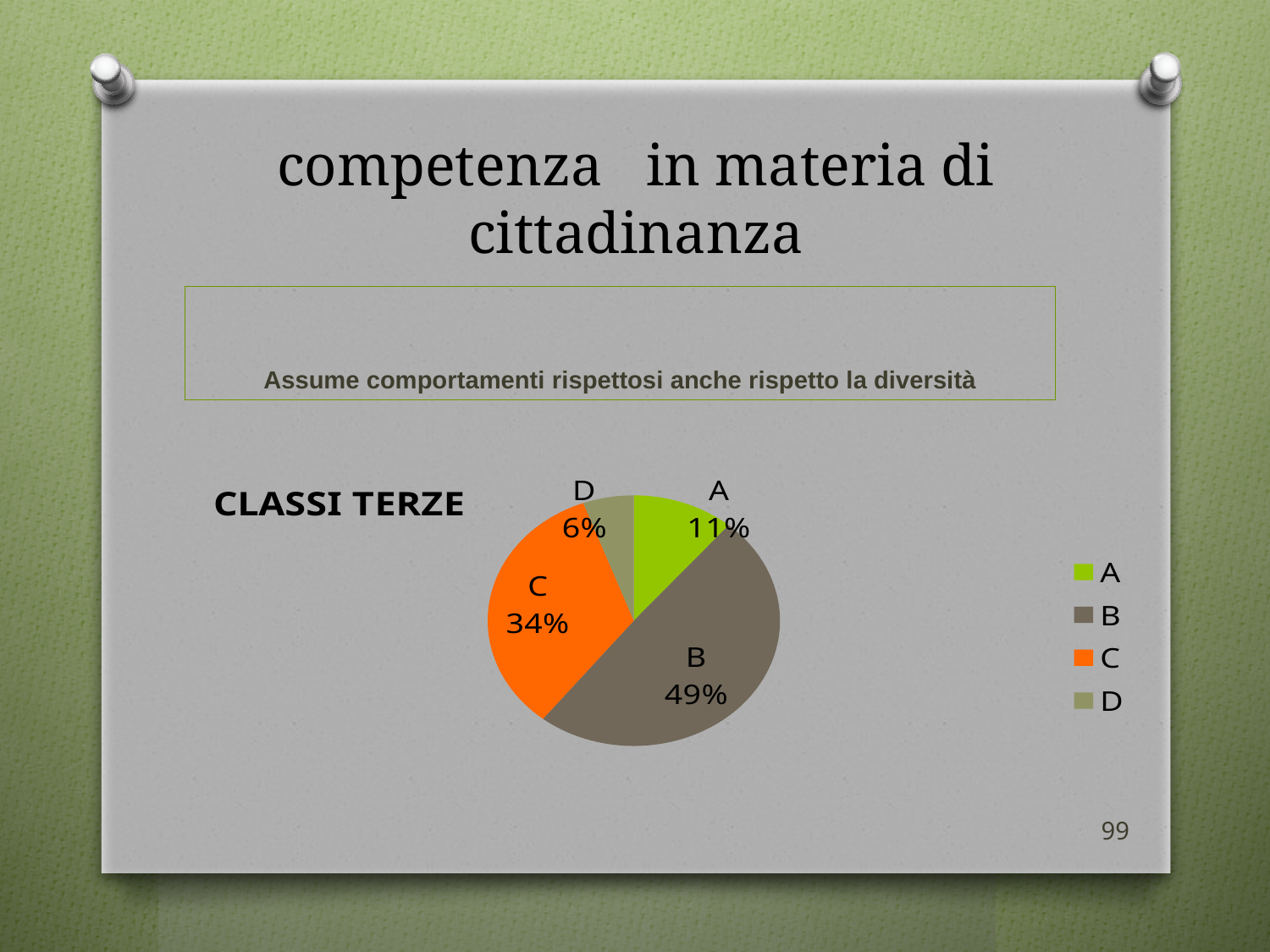
What is the share for category D in the pie chart? 6% Which is larger, the share for A or the share for D? A What colour is the slice for category C? orange How many entries does the legend list? 4 Which category has the largest slice of the pie chart? B What is the share for category A in the pie chart? 11% What is the difference in percentage points between category B and category C? 15 What is the share for category C in the pie chart? 34% Which category has the smallest slice of the pie chart? D How many slices does the pie chart have? 4 What is the share for category B in the pie chart? 49% What kind of chart is shown on the slide? pie chart